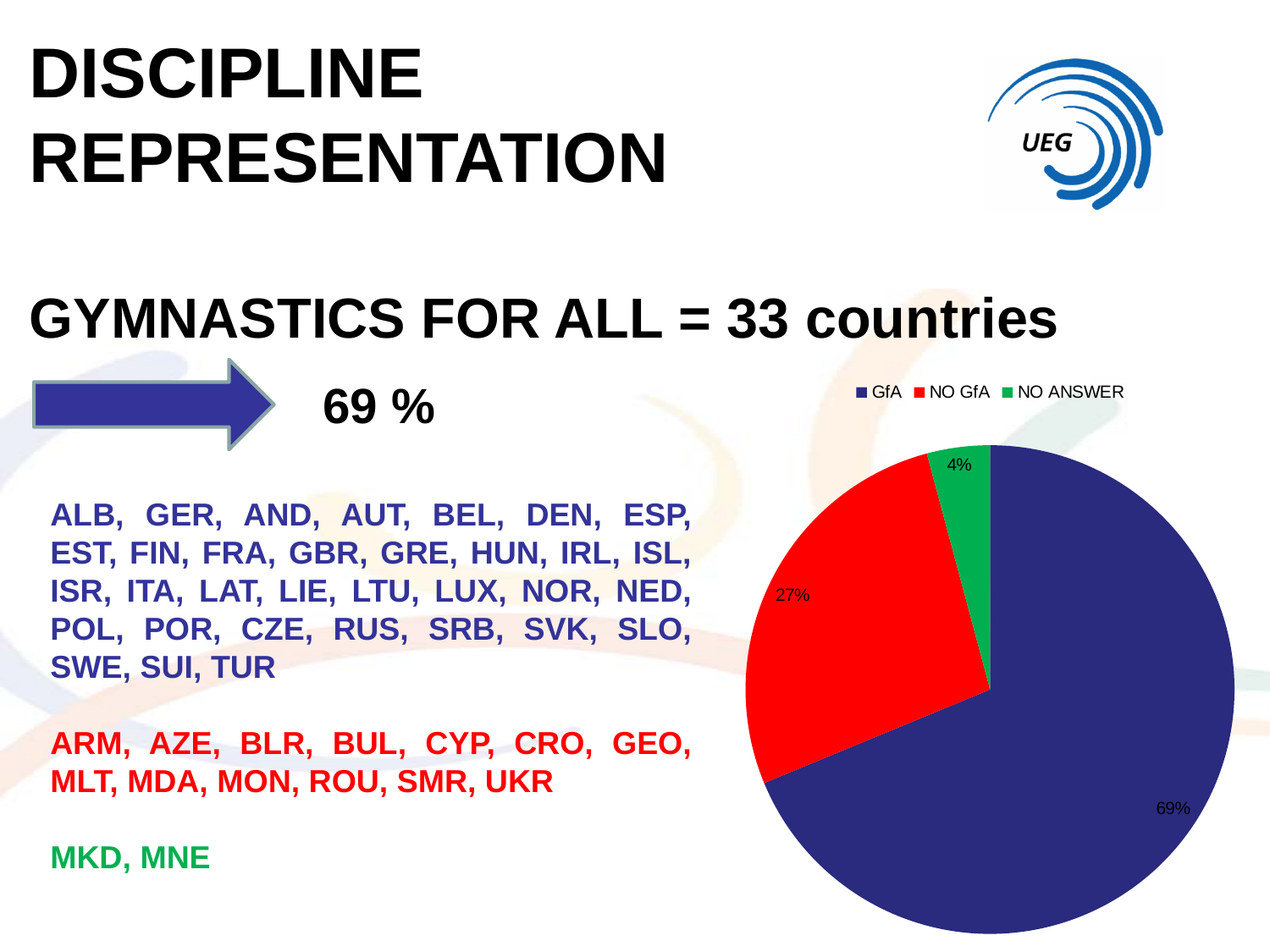
What colour is the GfA slice in the pie chart? dark blue How many entries does the legend of the pie chart list? 3 How many slices does the pie chart have? 3 What share of the pie does NO GfA represent? 27% Which slice of the pie chart is the largest? GfA What share of the pie does GfA represent? 69% What colour is the NO ANSWER slice in the pie chart? green What is the difference in percentage points between the GfA slice and the NO GfA slice? 42 What kind of chart is shown on the slide? pie chart Which is larger, the NO GfA slice or the NO ANSWER slice? NO GfA What share of the pie does NO ANSWER represent? 4% Which slice of the pie chart is the smallest? NO ANSWER